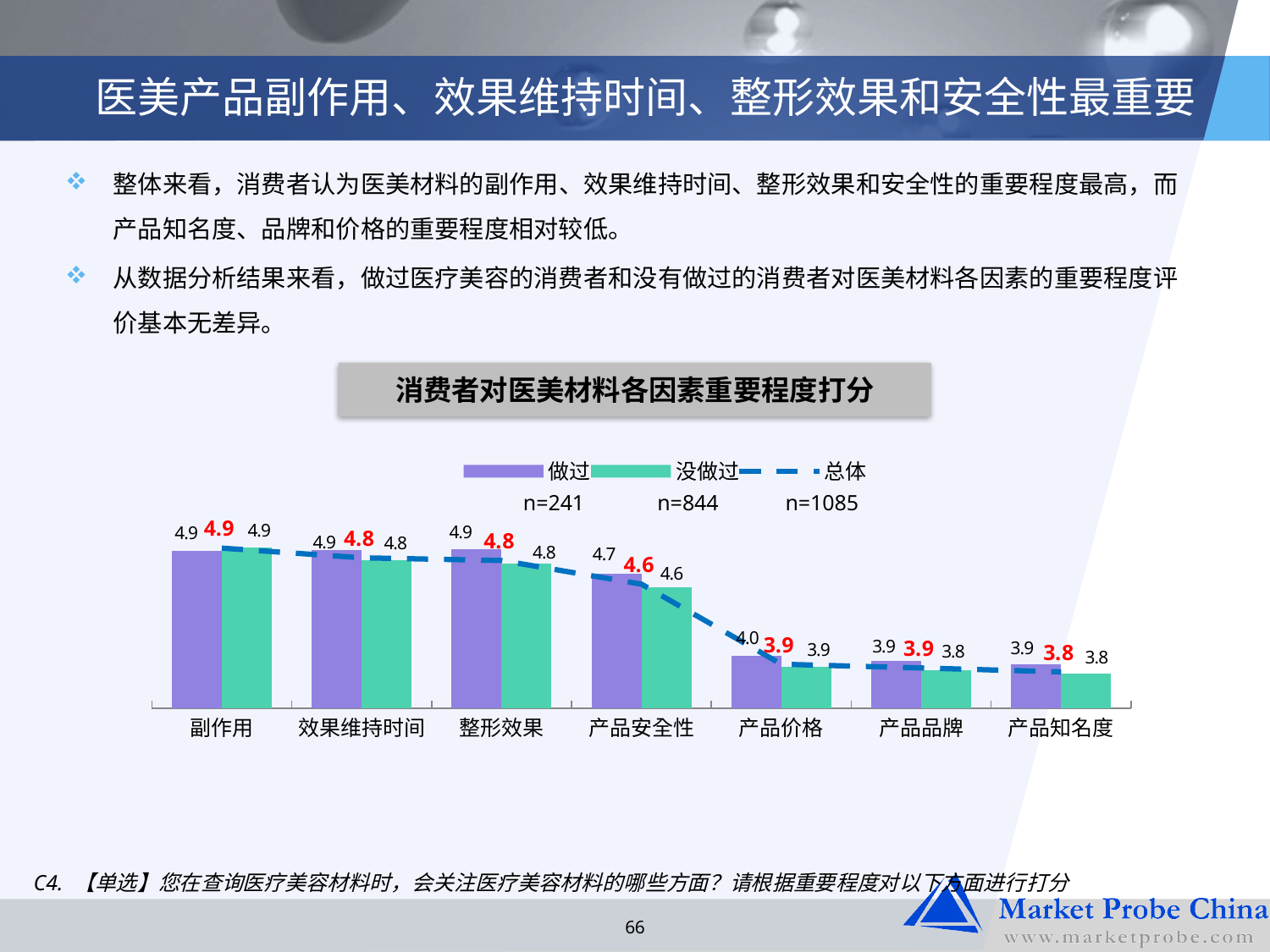
What type of chart is used to show the 做过 and 没做过 scores? Bar chart Which category has the lowest 总体 score? 产品知名度 What is the 总体 score for 产品知名度? 3.8 How many series does the legend list? 3 Which category has the highest 总体 score? 副作用 What is the 没做过 score for 产品价格? 3.9 Which is larger, the 做过 score for 产品安全性 or the 没做过 score for 产品安全性? 做过 (4.7) Do the 总体 scores rise or fall moving from 副作用 to 产品知名度 along the x axis? Fall What is the title of the chart? 消费者对医美材料各因素重要程度打分 What is the difference between the 做过 score for 副作用 and the 做过 score for 产品价格? 0.9 What is the 做过 score for 产品安全性? 4.7 How many categories are shown on the x axis? 7